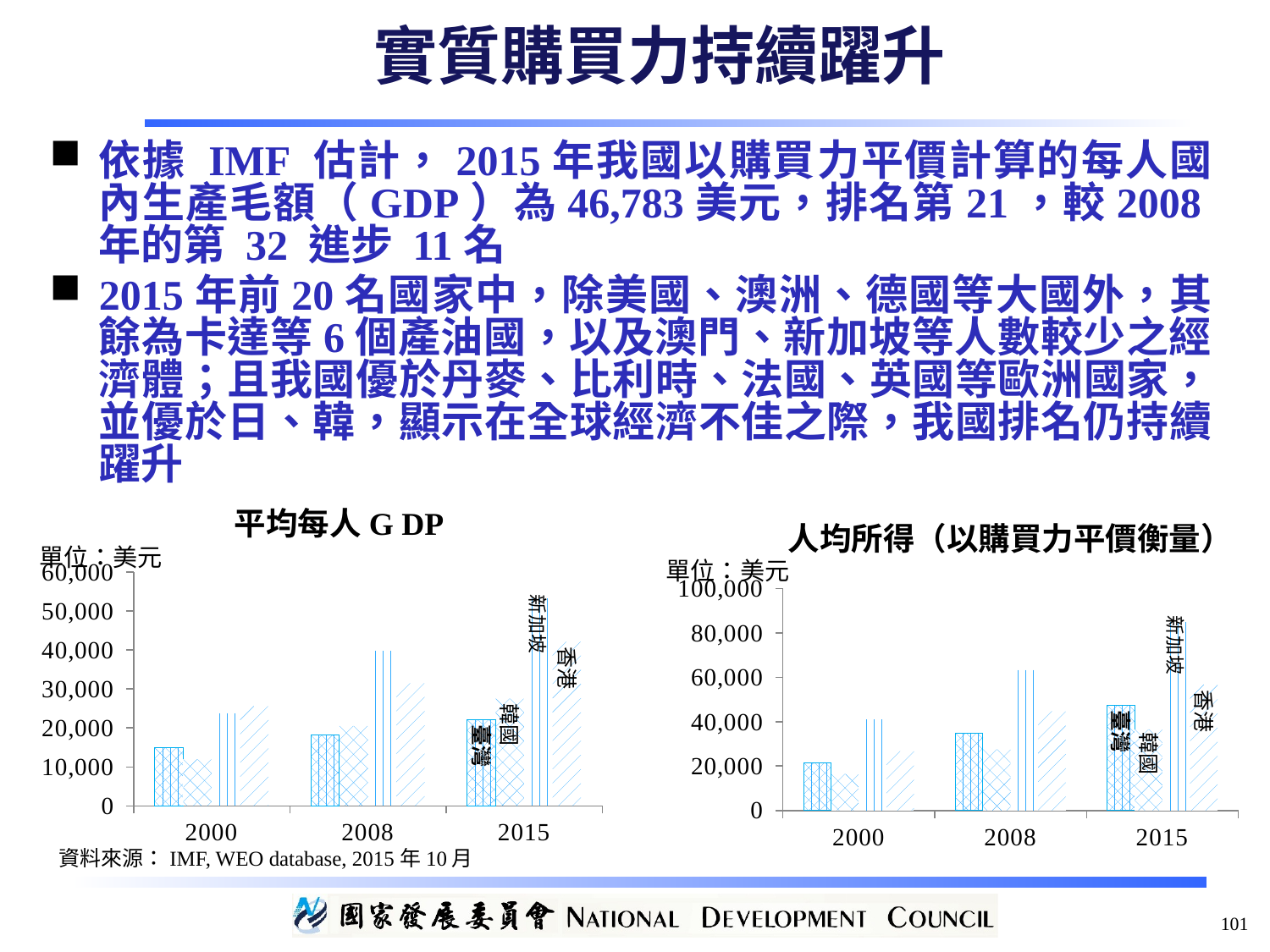
In the right chart 人均所得（以購買力平價衡量）, which economy has the lowest bar in 2015? 韓國 In the right chart 人均所得（以購買力平價衡量）, is the 2015 bar for 臺灣 higher or lower than the 2015 bar for 韓國? higher In the left chart 平均每人GDP, is the value for 新加坡 in 2015 greater or less than 40,000? greater What unit is stated for the values in the left chart 平均每人GDP? 美元 How many years are shown on the x axis of the right chart titled 人均所得（以購買力平價衡量）? 3 In the right chart 人均所得（以購買力平價衡量）, is the value for 臺灣 in 2015 greater or less than 40,000? greater What kind of chart is the left chart titled 平均每人GDP? bar chart In the left chart 平均每人GDP, which economy has the highest bar in 2015? 新加坡 In the left chart 平均每人GDP, is the value for 臺灣 in 2015 greater or less than 30,000? less In the right chart 人均所得（以購買力平價衡量）, do the bars for 新加坡 rise or fall from 2000 to 2015? rise In the left chart 平均每人GDP, is the 2015 bar for 韓國 higher or lower than the 2015 bar for 臺灣? higher